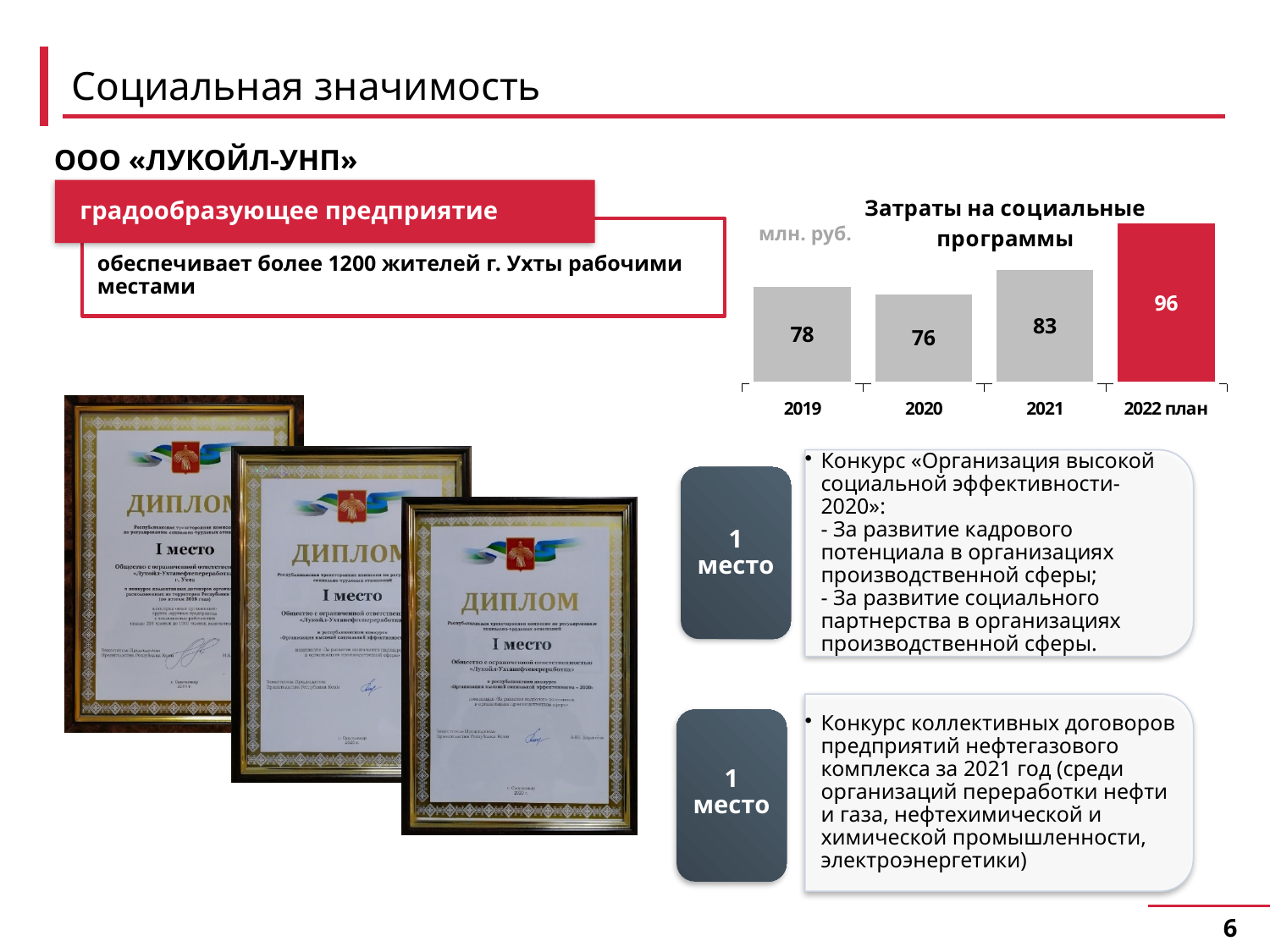
What kind of chart is 'Затраты на социальные программы'? bar chart Which category has the highest value in the 'Затраты на социальные программы' chart? 2022 план Which category has the lowest value in the 'Затраты на социальные программы' chart? 2020 What is the difference between the values for 2019 and 2020 in the 'Затраты на социальные программы' chart? 2 What is the difference between the values for '2022 план' and 2021 in the 'Затраты на социальные программы' chart? 13 Which is larger in the 'Затраты на социальные программы' chart, the value for 2021 or the value for 2019? 2021 What is the value for 2021 in the 'Затраты на социальные программы' chart? 83 What is the value for 2019 in the 'Затраты на социальные программы' chart? 78 How many categories are shown in the 'Затраты на социальные программы' chart? 4 What is the value for 2020 in the 'Затраты на социальные программы' chart? 76 What unit is indicated for the values in the 'Затраты на социальные программы' chart? млн. руб. What is the value for '2022 план' in the 'Затраты на социальные программы' chart? 96